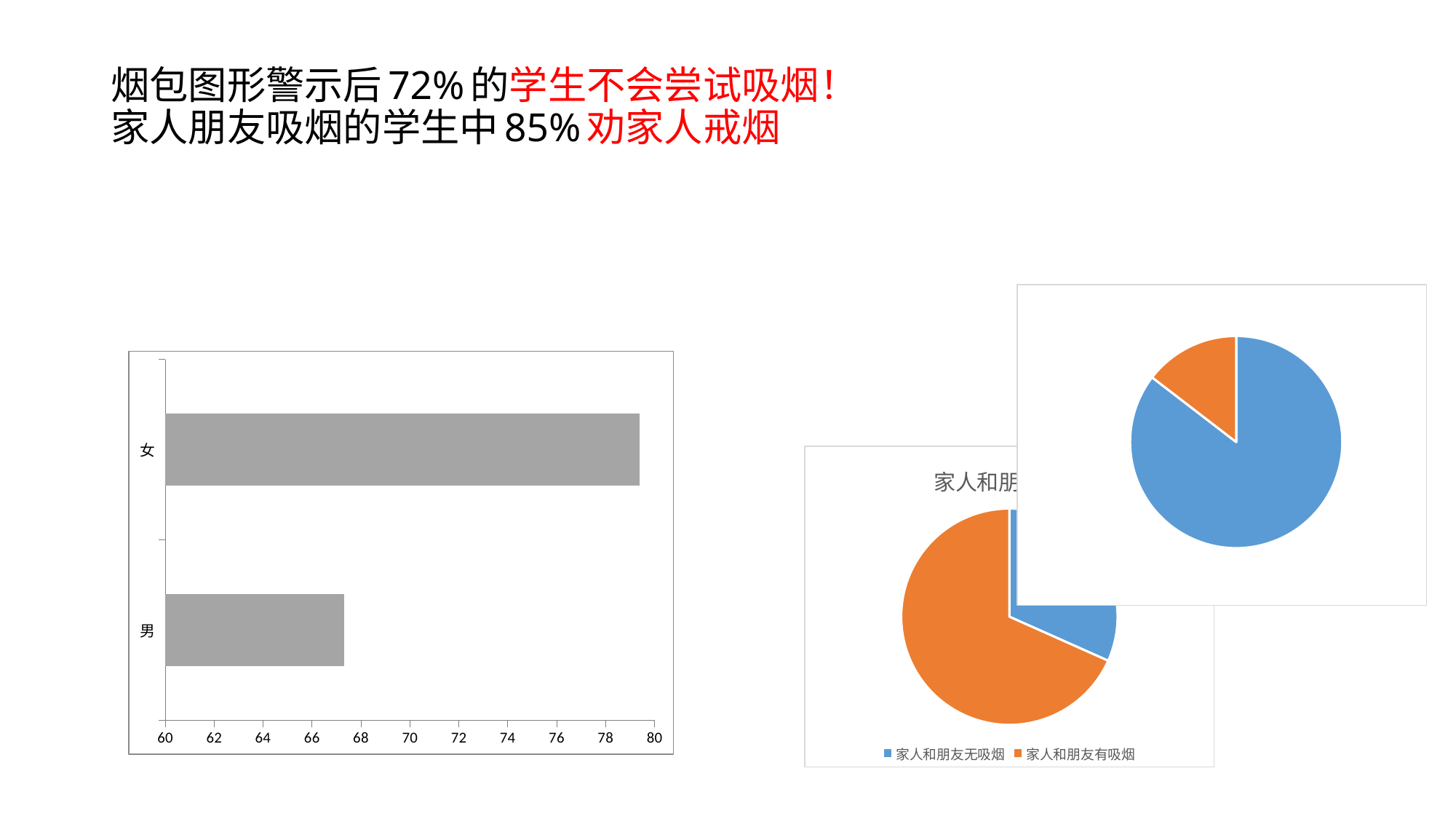
In the bar chart on the left, is the value for 男 greater or less than 66? greater In the bar chart on the left, which category has the lower value? 男 In the bar chart on the left, is the value for 女 larger or smaller than the value for 男? larger How many categories does the bar chart on the left show? 2 In the bar chart on the left, which category has the higher value? 女 In the pie chart at the top right of the slide, which colour slice is larger, blue or orange? blue In the bar chart on the left, is the value for 男 greater or less than 68? less What kind of chart is the chart on the left of the slide? bar chart In the pie chart in the lower middle of the slide, which slice is larger, 家人和朋友无吸烟 or 家人和朋友有吸烟? 家人和朋友有吸烟 In the bar chart on the left, is the value for 女 greater or less than 78? greater What is the lowest value shown on the horizontal axis of the bar chart on the left? 60 How many entries does the legend of the pie chart in the lower middle of the slide list? 2